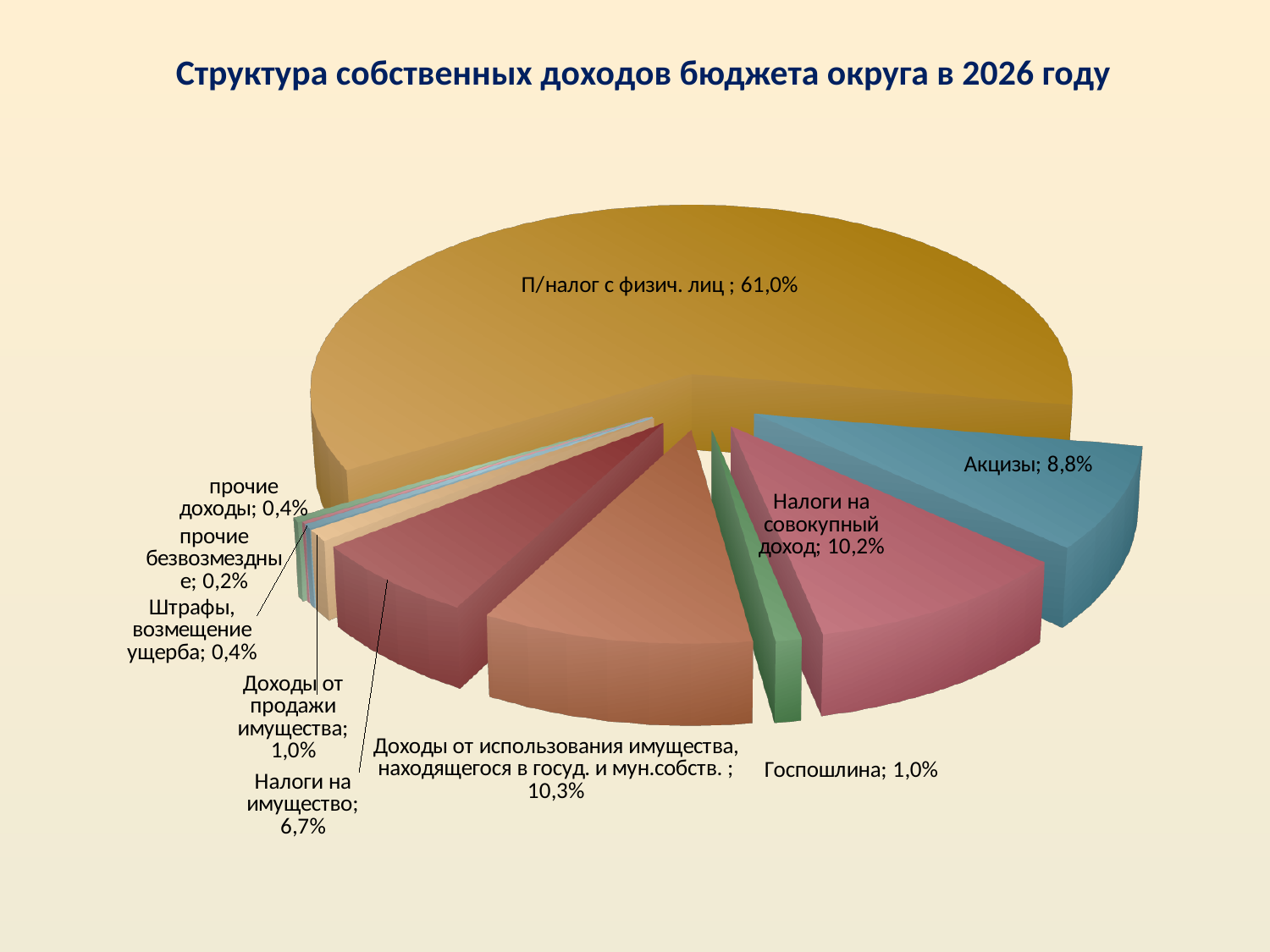
What share of the pie does "П/налог с физич. лиц" represent? 61,0% What is the value shown for "Акцизы"? 8,8% Which category has the smallest share of the pie? прочие безвозмездные Which category has the largest share of the pie? П/налог с физич. лиц What is the difference between the shares of "Акцизы" and "Налоги на имущество"? 2,1 percentage points What is the value shown for "Доходы от использования имущества, находящегося в госуд. и мун.собств."? 10,3% How many categories (slices) does the pie chart show? 10 What is the value shown for "Налоги на совокупный доход"? 10,2% What is the difference between the shares of "П/налог с физич. лиц" and "Акцизы"? 52,2 percentage points What type of chart is shown on the slide? Pie chart Which is larger: the share of "Акцизы" or the share of "Налоги на имущество"? Акцизы What is the value shown for "Налоги на имущество"? 6,7%